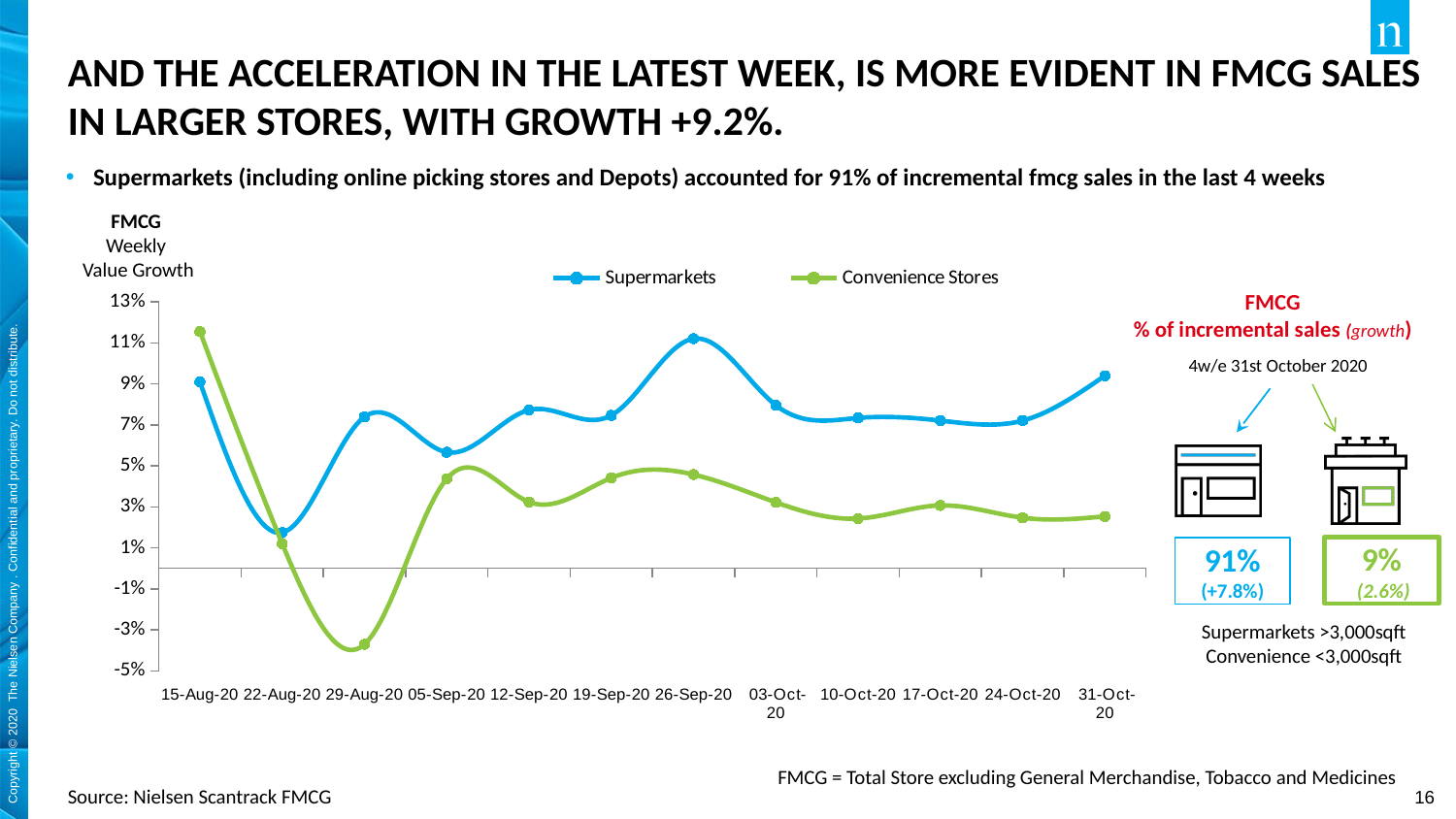
Is the value for Supermarkets on 22-Aug-20 greater or less than 3%? less Which colour is used for the Convenience Stores line in the chart? green On which date does the Supermarkets line reach its lowest value? 22-Aug-20 On which date does the Supermarkets line reach its highest value? 26-Sep-20 How many series does the chart legend list? 2 Is the value for Convenience Stores on 29-Aug-20 greater or less than -3%? less On which date does the Convenience Stores line reach its highest value? 15-Aug-20 How many weekly dates are shown along the x axis of the chart? 12 On which date does the Convenience Stores line reach its lowest value? 29-Aug-20 What kind of chart is shown on the slide? line chart Is the value for Supermarkets on 26-Sep-20 greater or less than 9%? greater On 31-Oct-20, which series has the higher value, Supermarkets or Convenience Stores? Supermarkets